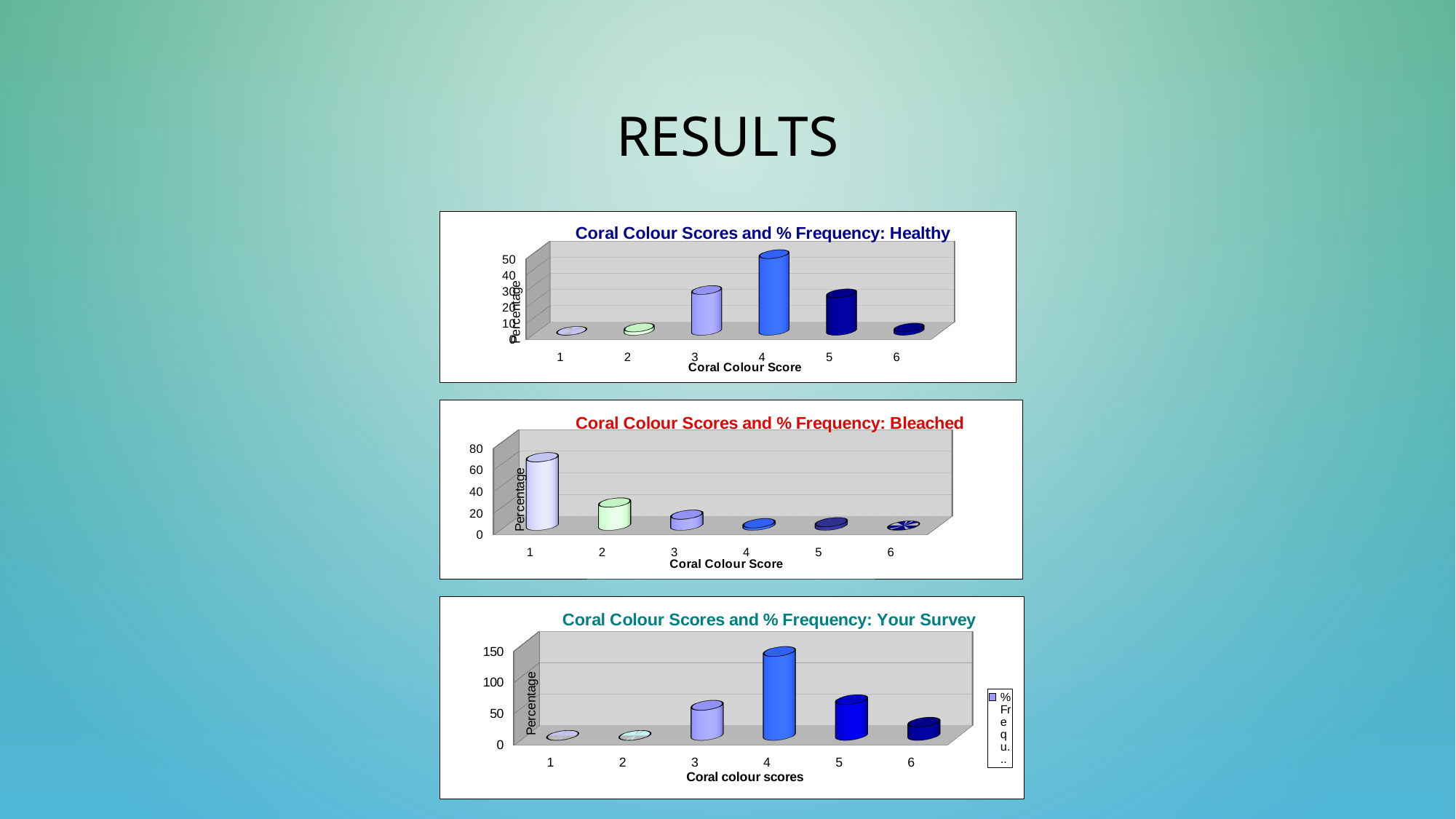
In the 'Coral Colour Scores and % Frequency: Bleached' chart, is the value for coral colour score 1 greater or less than 60? greater In the 'Coral Colour Scores and % Frequency: Healthy' chart, is the value for coral colour score 4 greater or less than 40? greater In the 'Coral Colour Scores and % Frequency: Healthy' chart, which is larger, the value for score 4 or the value for score 6? score 4 In the 'Coral Colour Scores and % Frequency: Your Survey' chart, which coral colour score has the highest percentage? 4 In the 'Coral Colour Scores and % Frequency: Bleached' chart, is the value for coral colour score 2 greater or less than 40? less What kind of chart is the 'Coral Colour Scores and % Frequency: Healthy' chart? bar chart In the 'Coral Colour Scores and % Frequency: Healthy' chart, which coral colour score has the highest percentage? 4 How many coral colour score categories are shown on the x axis of the 'Coral Colour Scores and % Frequency: Your Survey' chart? 6 In the 'Coral Colour Scores and % Frequency: Your Survey' chart, which is larger, the value for score 5 or the value for score 6? score 5 In the 'Coral Colour Scores and % Frequency: Bleached' chart, do the values rise or fall as the coral colour score increases from 1 to 6? fall In the 'Coral Colour Scores and % Frequency: Bleached' chart, which coral colour score has the highest percentage? 1